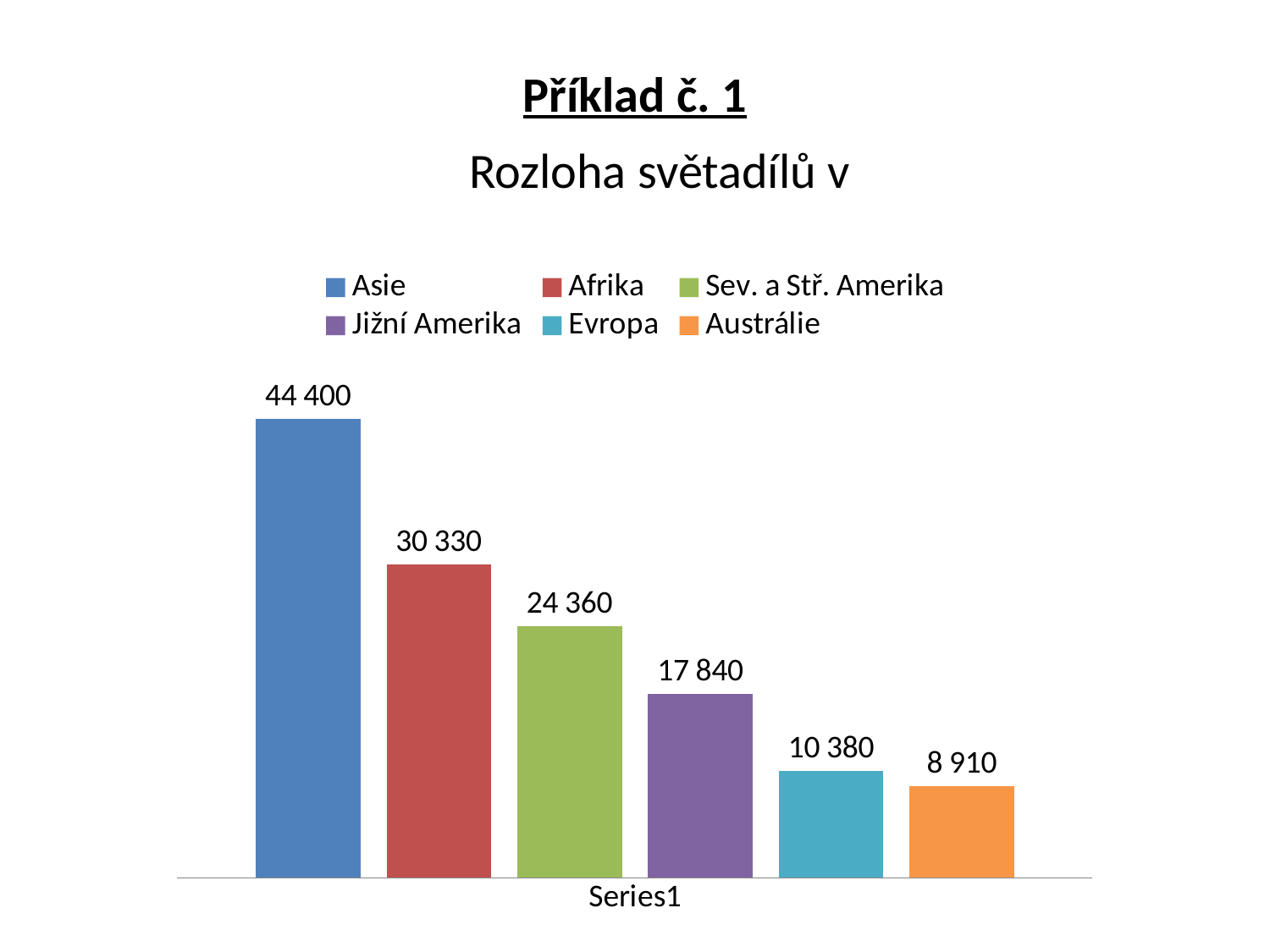
What is the value shown for Sev. a Stř. Amerika? 24 360 Which continent has the lowest value in the chart? Austrálie Which has a larger value, Jižní Amerika or Evropa? Jižní Amerika What is the difference between the values for Evropa and Austrálie? 1 470 What is the value shown for Afrika? 30 330 What kind of chart is shown on the slide? Bar chart Which continent has the highest value in the chart? Asie What colour is the bar for Austrálie? Orange What is the value shown for Evropa? 10 380 How many series does the legend list? 6 What is the value shown for Asie? 44 400 What is the difference between the values for Asie and Afrika? 14 070